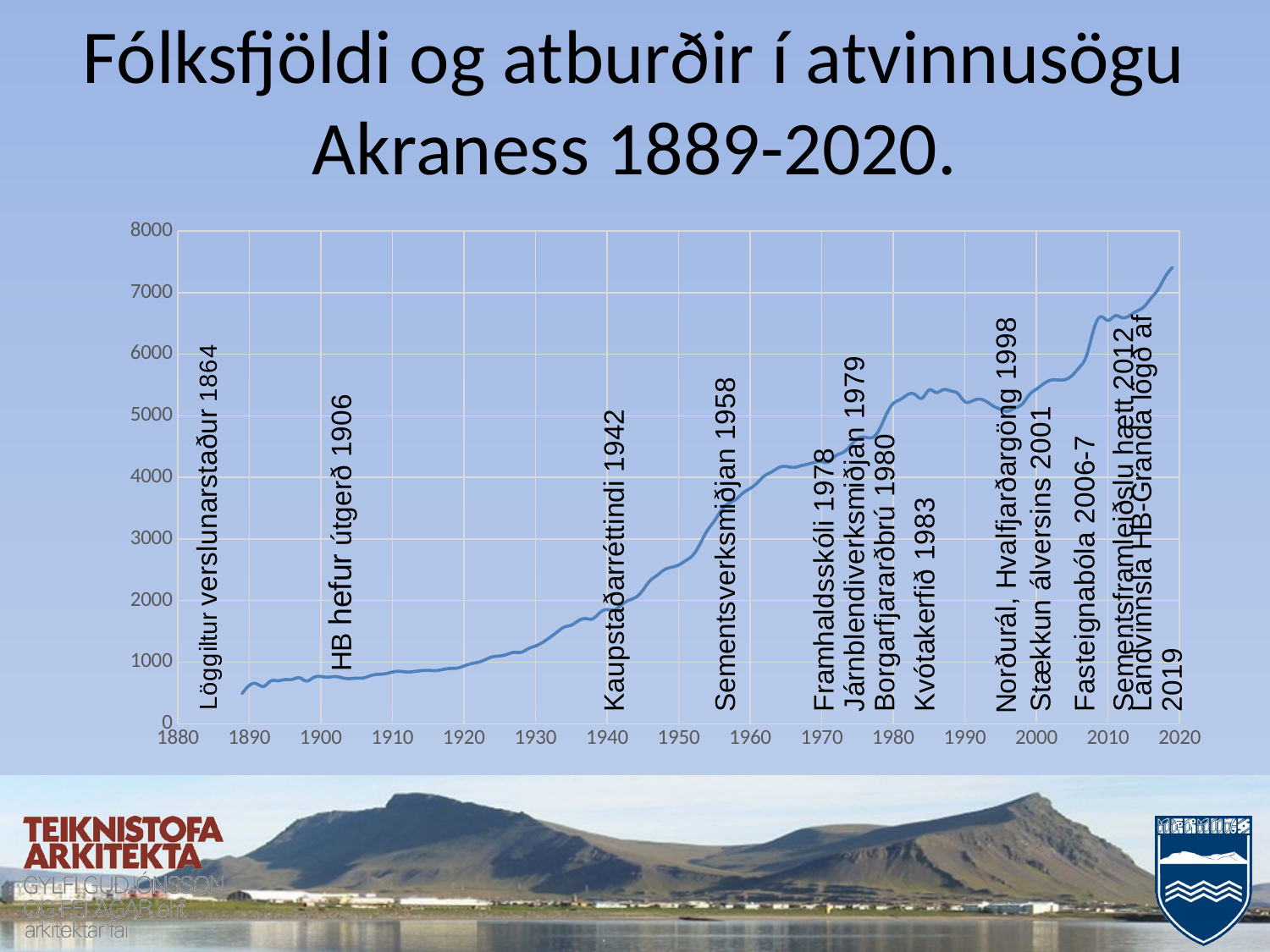
Is the value for 1930 greater or less than 1000? greater Is the value for 2020 greater or less than 7000? greater What is the title of the slide's chart? Fólksfjöldi og atburðir í atvinnusögu Akraness 1889-2020. Which event is annotated on the chart at 1942? Kaupstaðarréttindi 1942 Is the value for 1950 greater or less than 3000? less Which is larger, the value for 1970 or the value for 1950? 1970 What kind of chart is shown on the slide? line chart Does the plotted population generally rise or fall from 1890 to 2020? rise In which year does the line reach its highest value? 2019